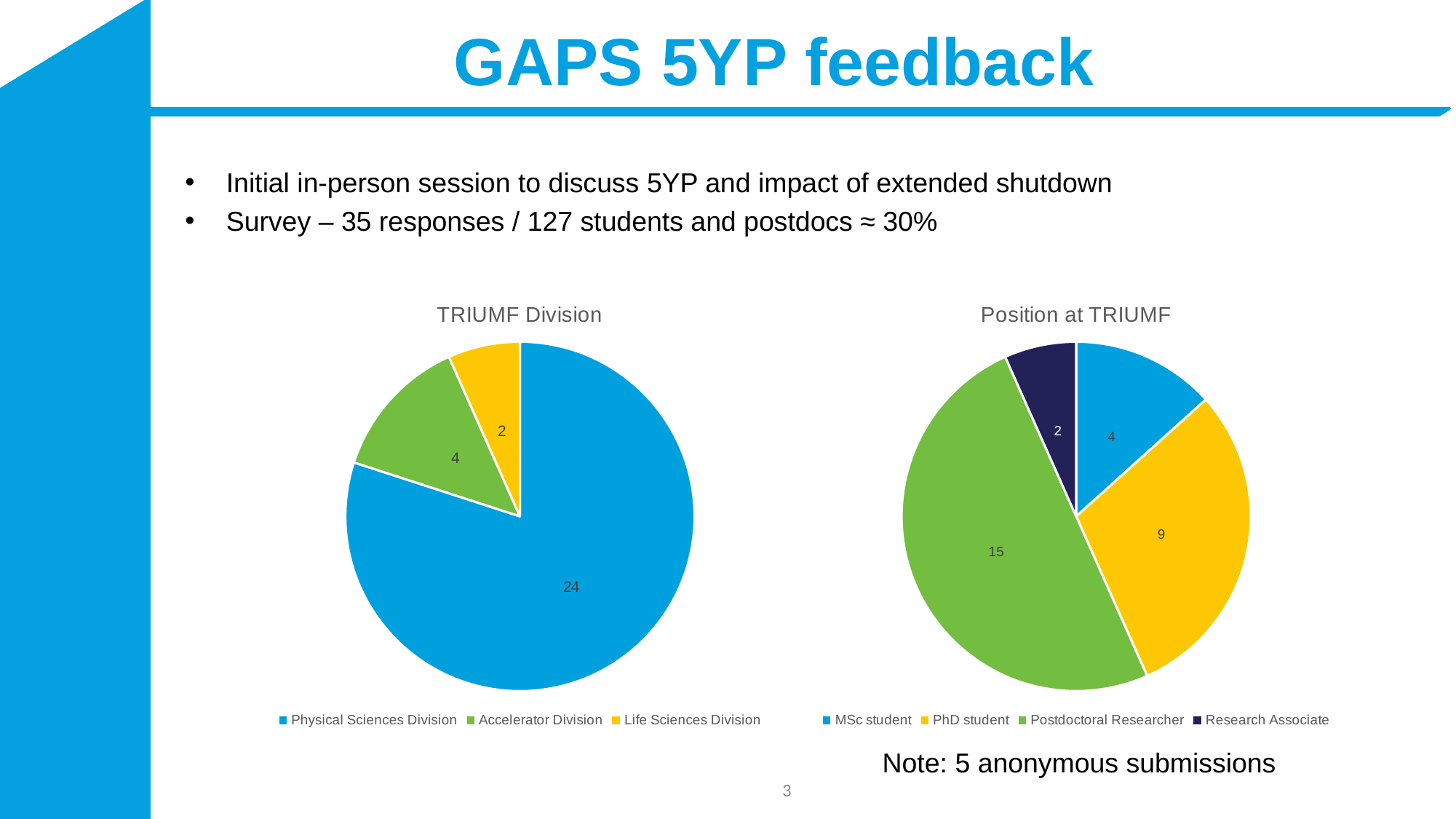
In the "TRIUMF Division" chart, what share of the total does Physical Sciences Division represent? 80% In the "Position at TRIUMF" chart, what is the value for Research Associate? 2 How many categories does the "Position at TRIUMF" chart have? 4 In the "TRIUMF Division" chart, which category has the smallest slice? Life Sciences Division In the "TRIUMF Division" chart, what is the value for Accelerator Division? 4 In the "Position at TRIUMF" chart, what is the difference between Postdoctoral Researcher and PhD student? 6 In the "Position at TRIUMF" chart, what is the value for PhD student? 9 In the "Position at TRIUMF" chart, which category has the largest slice? Postdoctoral Researcher What kind of chart is the "TRIUMF Division" chart? Pie chart In the "TRIUMF Division" chart, which is larger, Accelerator Division or Life Sciences Division? Accelerator Division In the "TRIUMF Division" chart, what is the value for Physical Sciences Division? 24 In the "Position at TRIUMF" chart, what share of the total does Postdoctoral Researcher represent? 50%